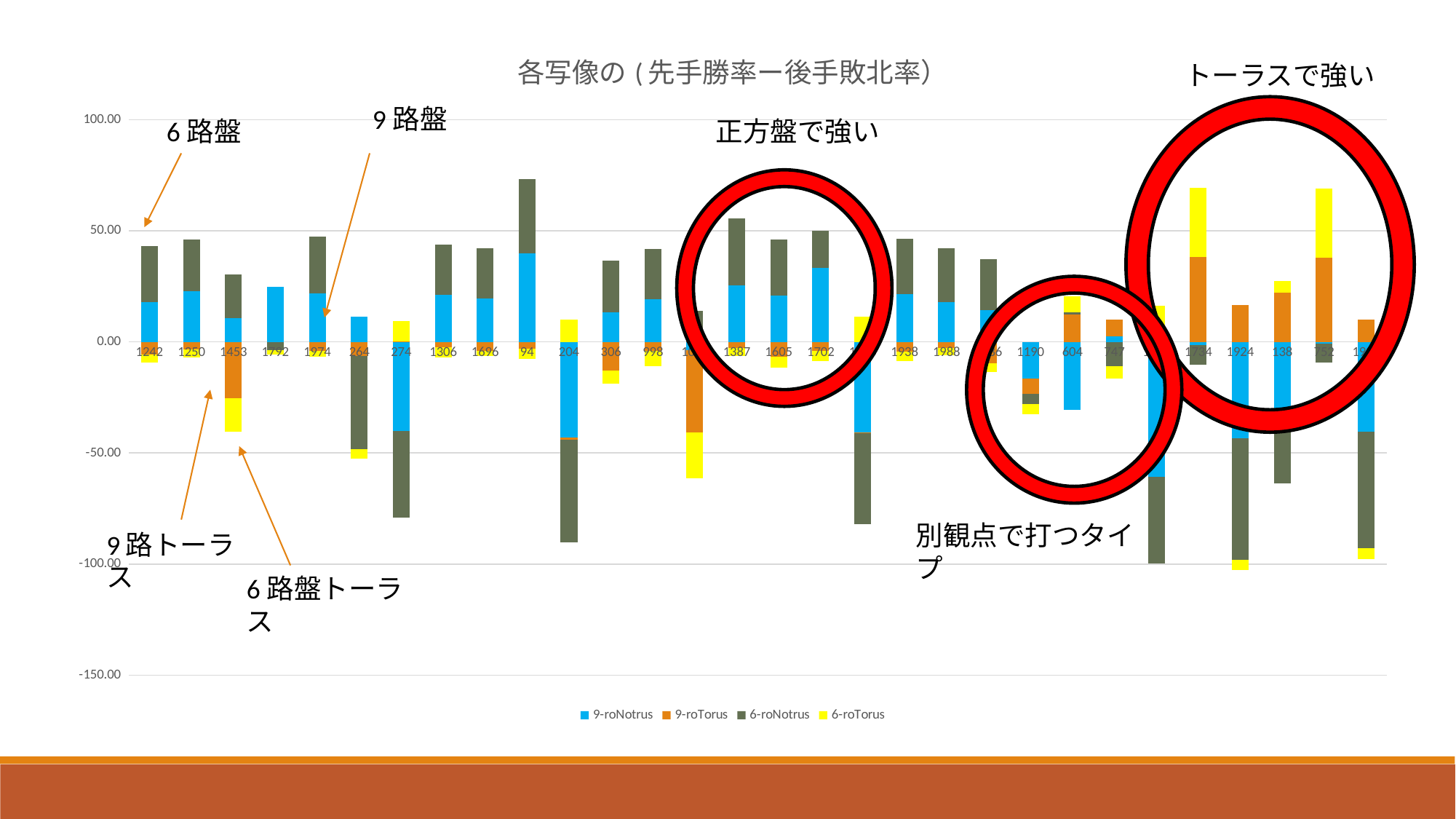
Is the top of the positive stacked bar for category 1242 greater or less than 50? less Is the top of the positive stacked bar for category 94 greater or less than 50? greater Is the top of the positive stacked bar for category 1734 greater or less than 50? greater How many series does the legend list? 4 Which colour represents the 6-roTorus series in the chart? yellow What kind of chart is shown on the slide? bar chart What is the title of the chart? 各写像の(先手勝率－後手敗北率) Which category's negative stacked bar extends further below zero, 274 or 264? 274 Which category has a taller positive stacked bar, 94 or 1242? 94